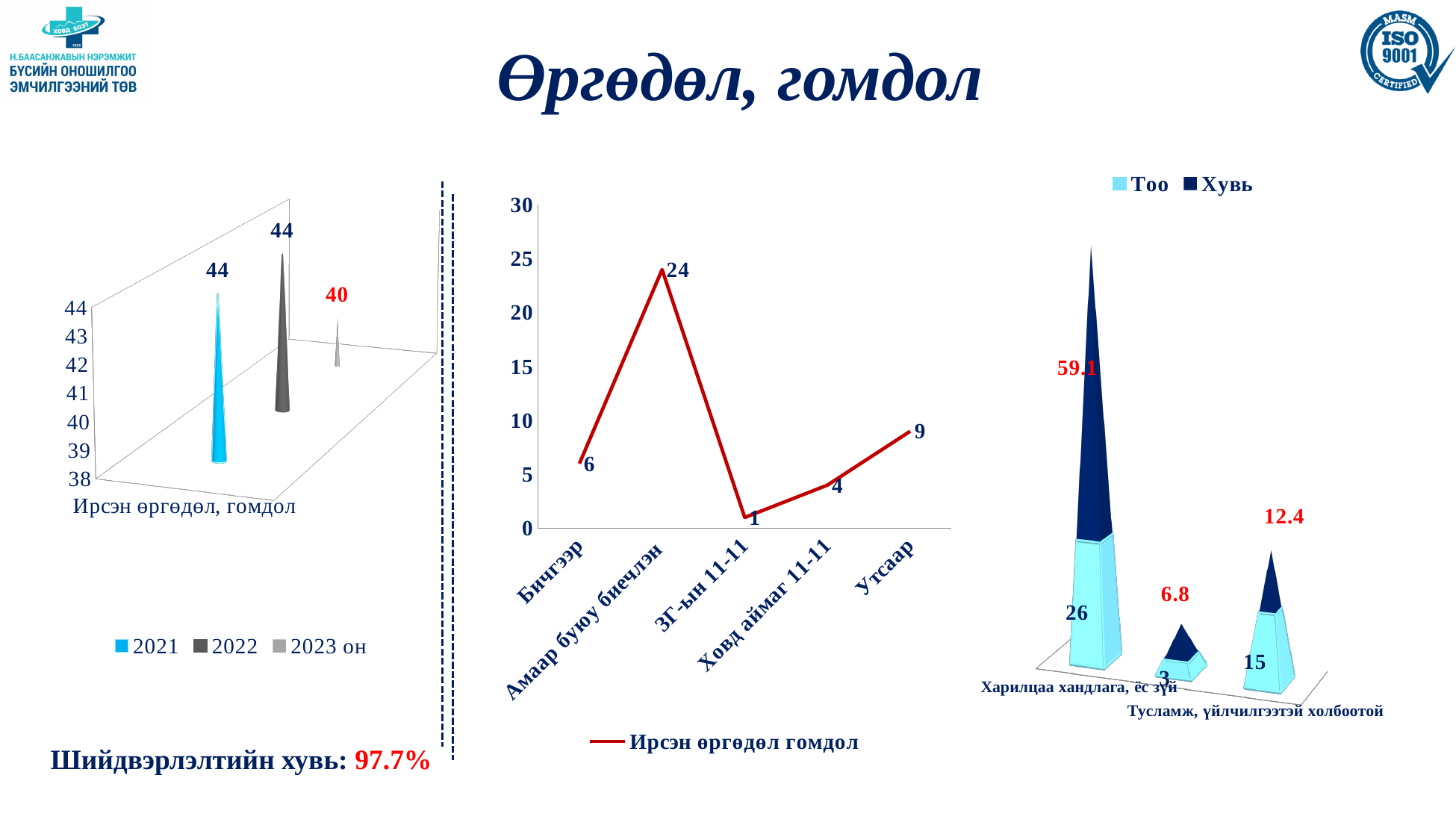
In the left chart, how many series does the legend list? 3 In the left chart, what is the value for 2021? 44 In the middle line chart, how many categories are plotted? 5 In the right chart, what is the highest value in the Хувь series? 59.1 In the middle line chart, which category has the lowest value? ЗГ-ын 11-11 In the right chart, how many series does the legend list? 2 In the left chart, what is the value for 2023 он? 40 In the middle line chart, what is the value for Амаар буюу биечлэн? 24 In the middle line chart, what is the difference between the values for Утсаар and Бичгээр? 3 In the middle line chart, which category has the highest value? Амаар буюу биечлэн In the middle chart, what type of chart is shown? line chart In the left chart, what is the difference between the 2022 value and the 2023 он value? 4